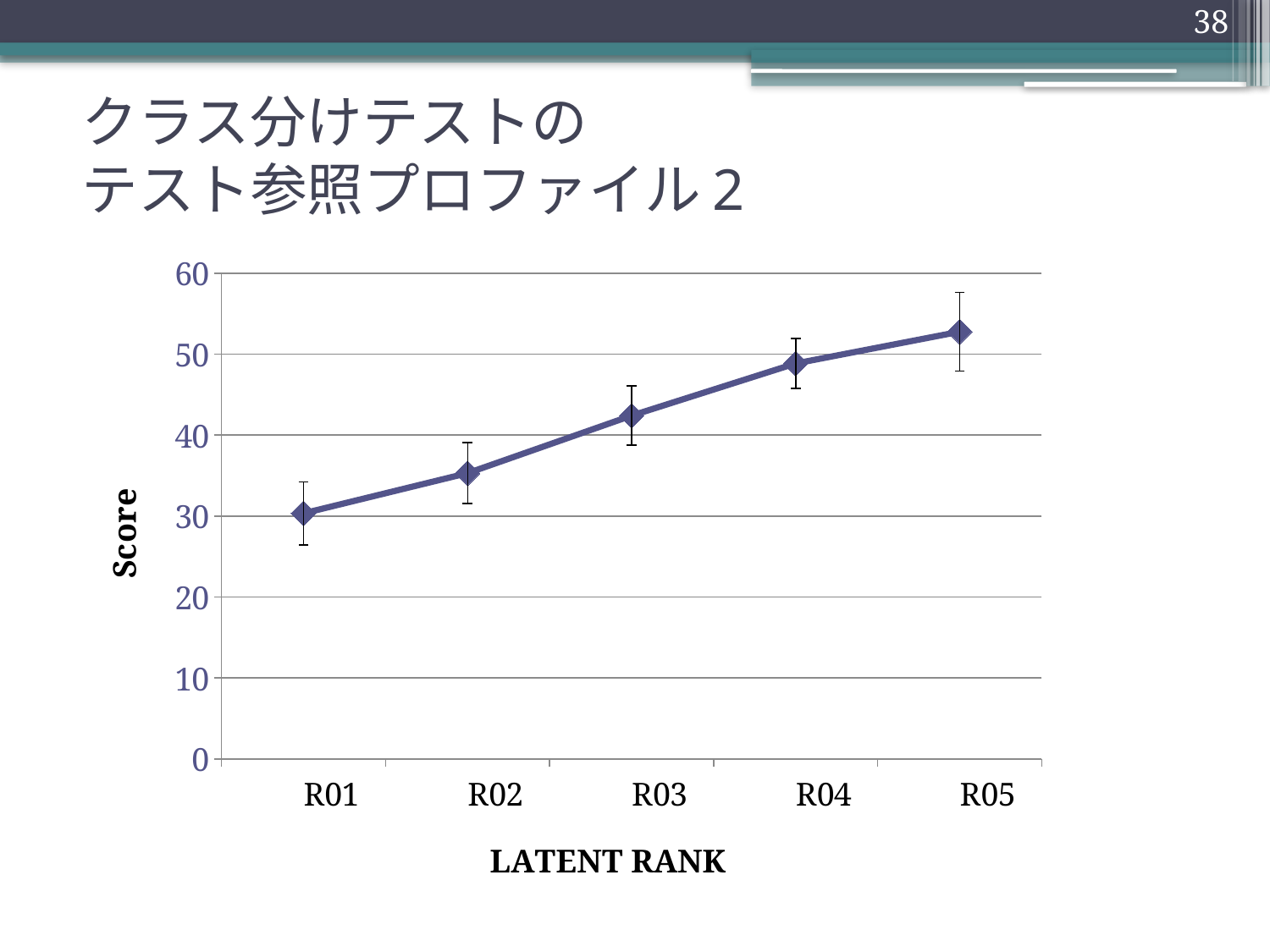
Is the score for R02 greater or less than 40? less Is the score for R03 greater or less than 40? greater Is the score for R05 greater or less than 50? greater How many latent rank categories are plotted on the x axis? 5 Do the scores rise or fall from R01 to R05? rise Which has the larger score, R02 or R03? R03 What kind of chart is shown on the slide? line chart Which latent rank has the lowest score? R01 Which latent rank has the highest score? R05 What is the title of the x axis? LATENT RANK